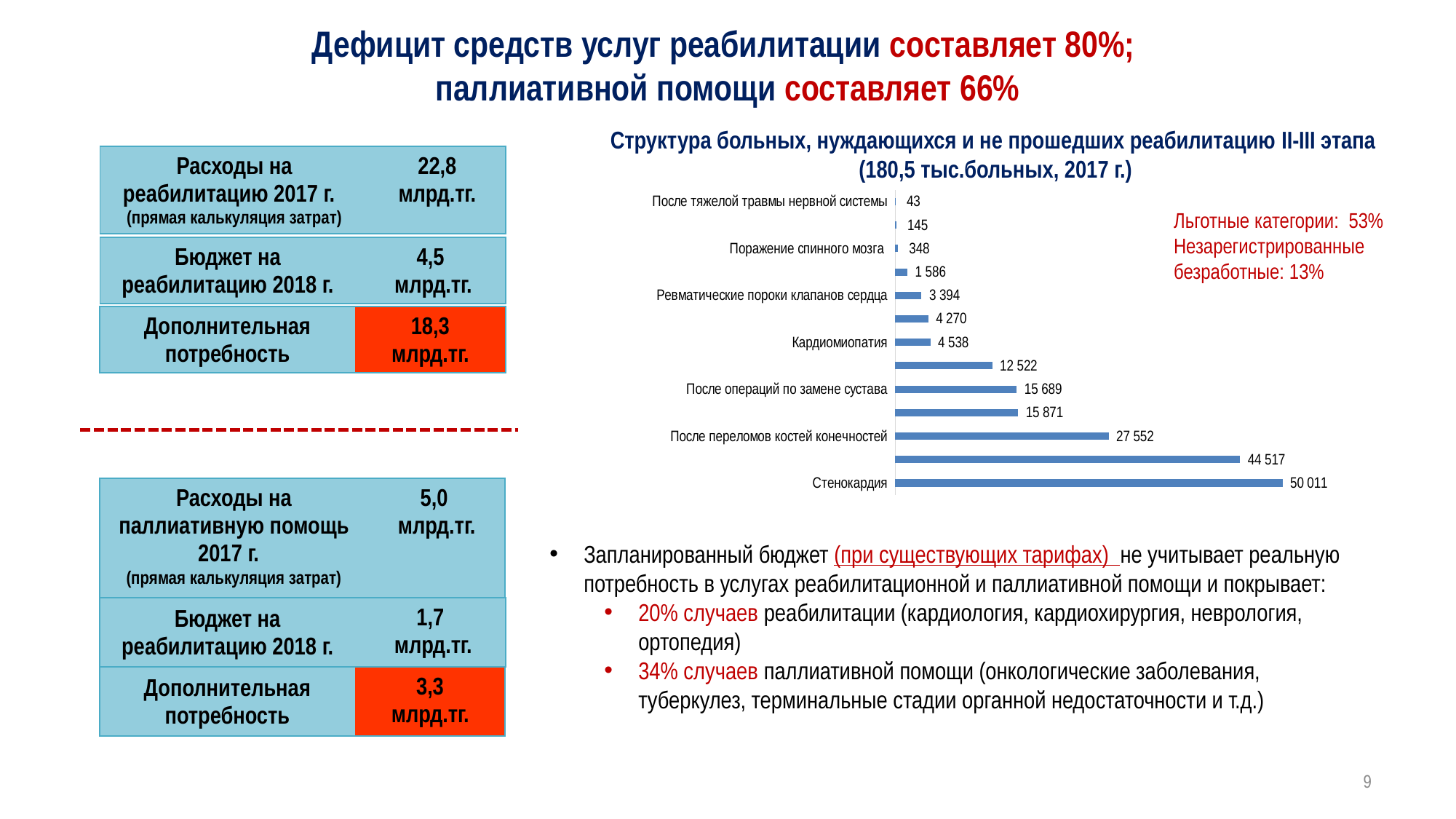
What is the difference between the values for Стенокардия and После переломов костей конечностей? 22 459 What type of chart is shown on the slide? Bar chart What is the value for Кардиомиопатия? 4 538 What is the title of the chart? Структура больных, нуждающихся и не прошедших реабилитацию II-III этапа (180,5 тыс.больных, 2017 г.) Which category has the lowest value? После тяжелой травмы нервной системы What is the value for Стенокардия? 50 011 What is the value for Поражение спинного мозга? 348 Which is larger: the value for Кардиомиопатия or the value for Ревматические пороки клапанов сердца? Кардиомиопатия What is the value for После операций по замене сустава? 15 689 How many bars are plotted in the chart? 13 What is the value for После переломов костей конечностей? 27 552 Which category has the highest value? Стенокардия